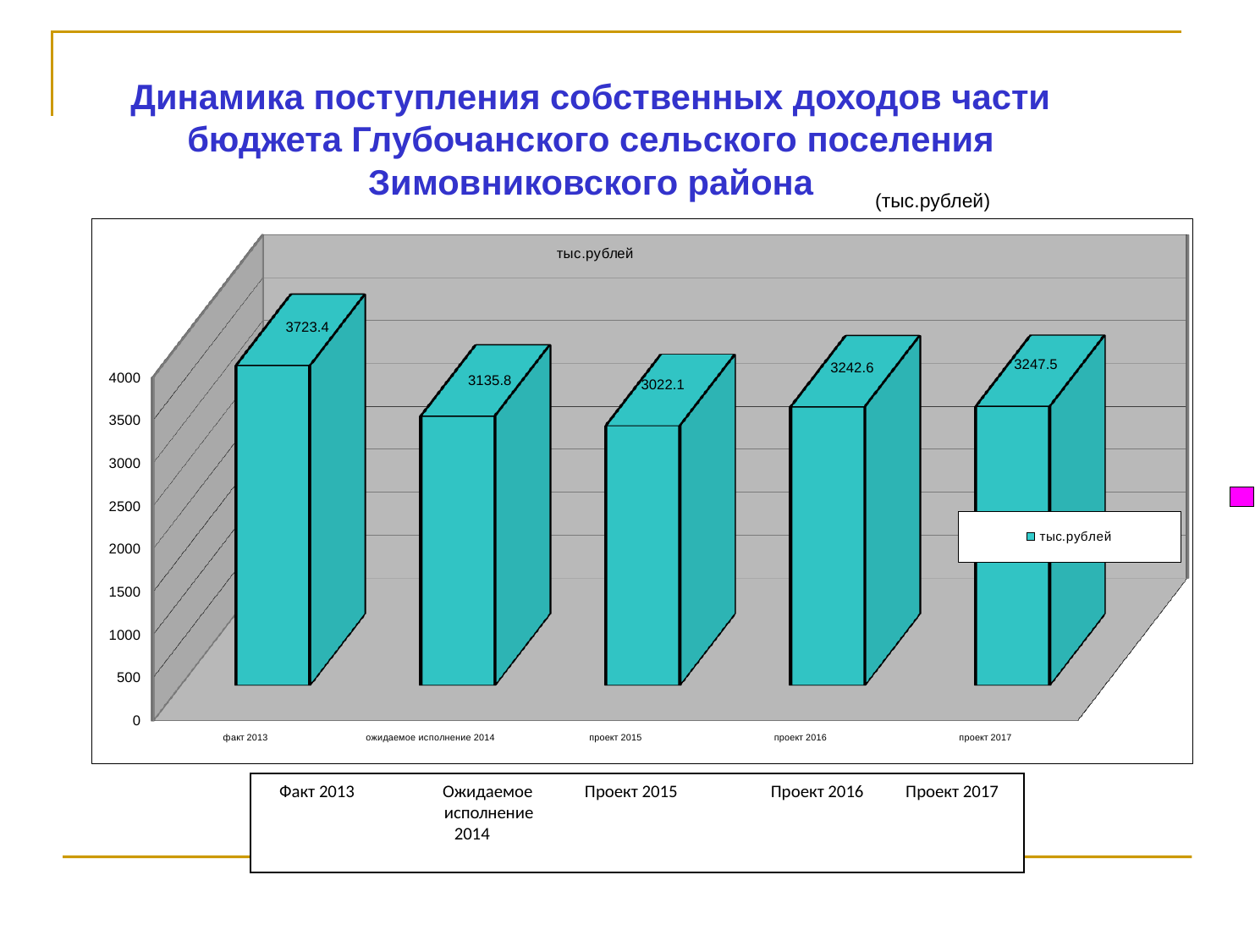
What is the value for проект 2017? 3247.5 What is the difference between the values for факт 2013 and ожидаемое исполнение 2014? 587.6 What is the value for факт 2013? 3723.4 How many categories are shown on the x axis? 5 What kind of chart is shown on the slide? bar chart Which category has the highest value? факт 2013 What is the value for ожидаемое исполнение 2014? 3135.8 What is the difference between the values for проект 2016 and проект 2015? 220.5 Which is larger, the value for факт 2013 or the value for проект 2016? факт 2013 Which category has the lowest value? проект 2015 What is the legend entry shown in the chart? тыс.рублей What is the value for проект 2015? 3022.1